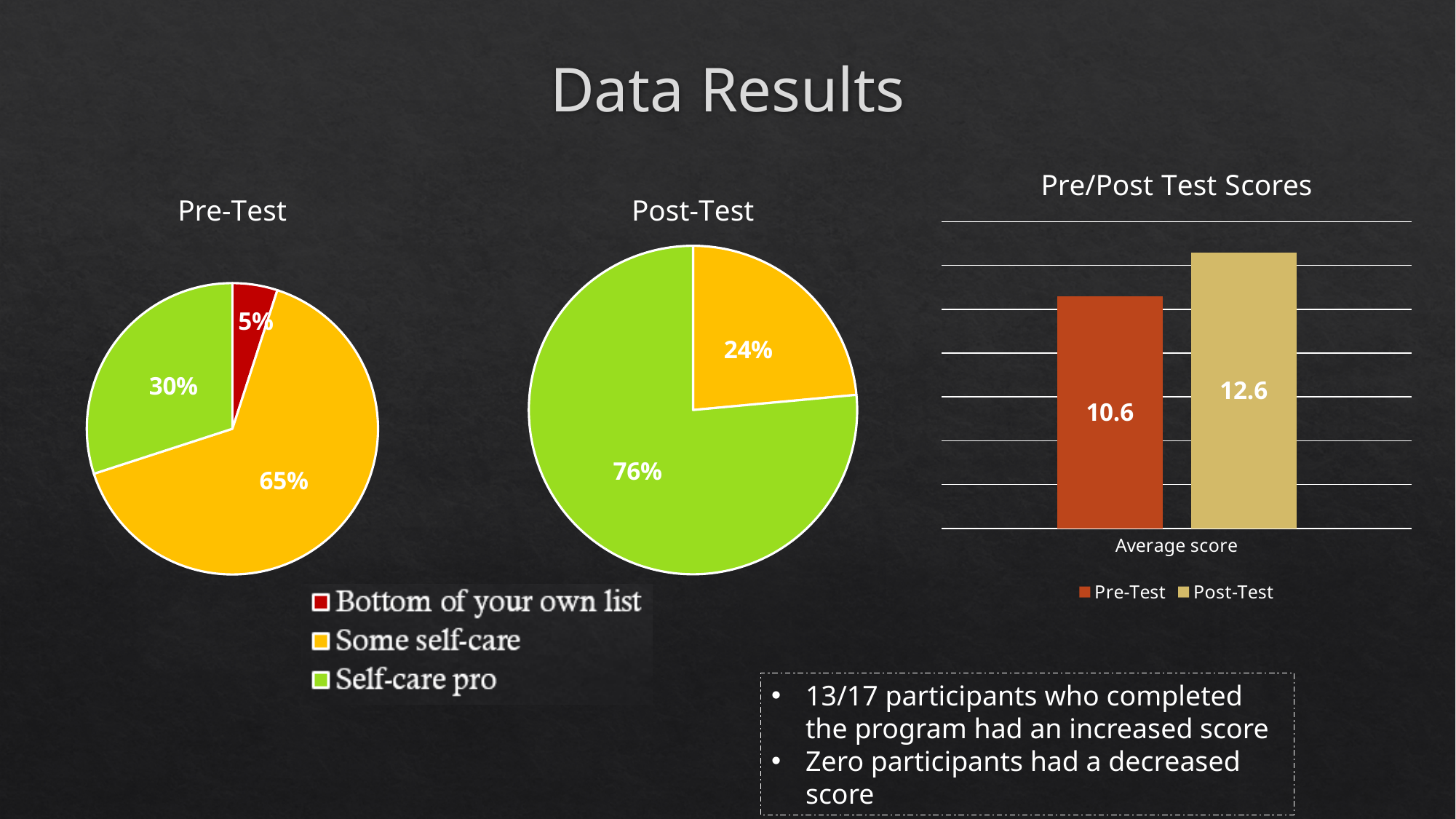
In the Post-Test pie chart, which category has the largest slice? Self-care pro What kind of chart is the Pre/Post Test Scores chart? Bar chart In the Pre/Post Test Scores chart, what is the difference between the Post-Test and Pre-Test average scores? 2 In the Pre-Test pie chart, what share is labelled for Some self-care? 65% In the Pre-Test pie chart, which category has the smallest slice? Bottom of your own list In the Pre/Post Test Scores chart, what is the Post-Test average score? 12.6 In the Pre/Post Test Scores chart, what is the Pre-Test average score? 10.6 In the Post-Test pie chart, what share is labelled for Self-care pro? 76% In the Pre-Test pie chart, which category has the largest slice? Some self-care In the Post-Test pie chart, what share is labelled for Some self-care? 24% In the Pre-Test pie chart, what share is labelled for Bottom of your own list? 5% In the Pre-Test pie chart, what share is labelled for Self-care pro? 30%